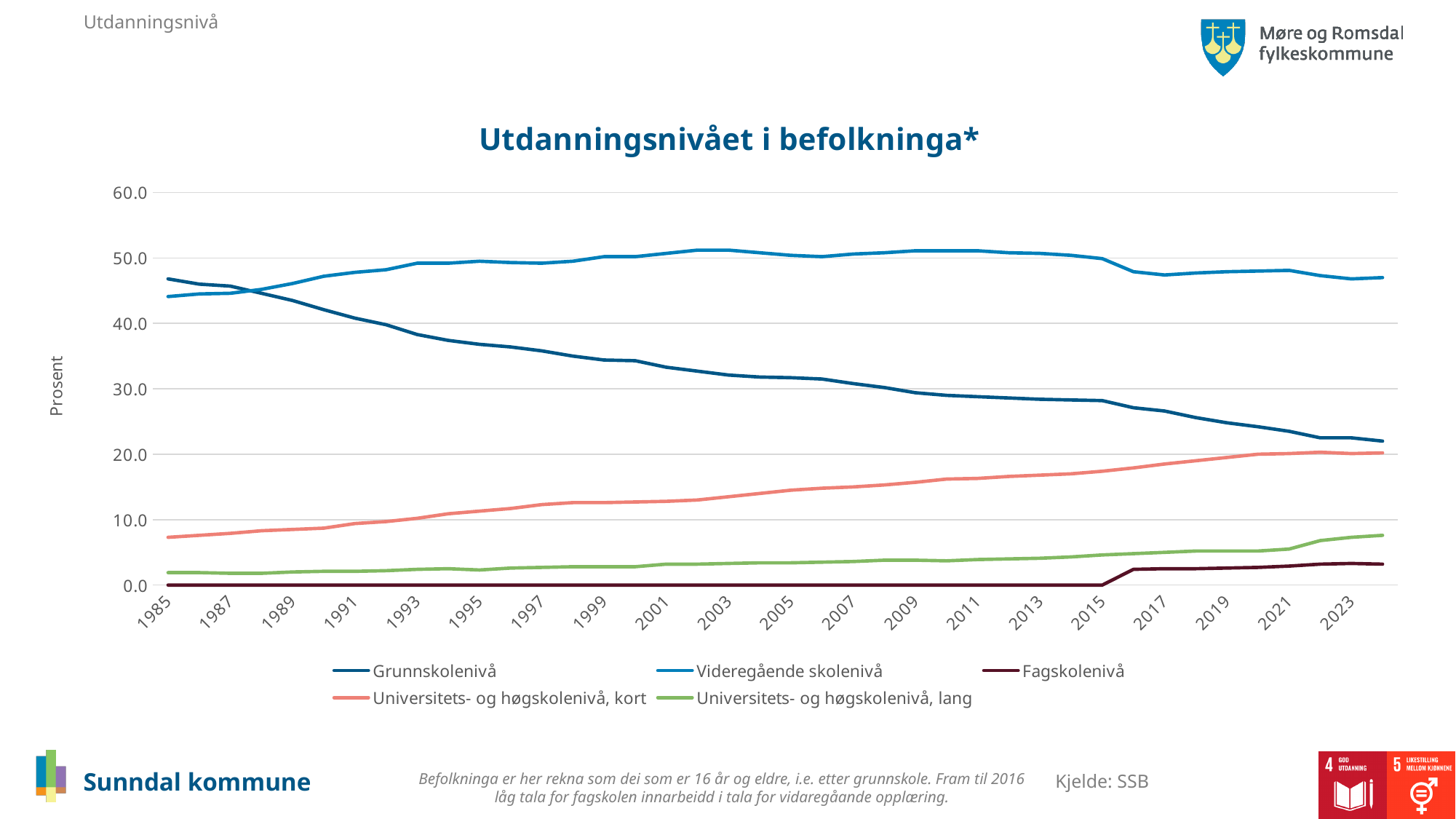
What kind of chart is shown on the slide? Line chart In 2023, which is larger: Universitets- og høgskolenivå, kort or Universitets- og høgskolenivå, lang? Universitets- og høgskolenivå, kort What is the title of the chart? Utdanningsnivået i befolkninga* Which series has the highest value in 2023? Videregående skolenivå Which series has the highest value in 1985? Grunnskolenivå What is the label on the y axis? Prosent Is the value for Grunnskolenivå in 2023 greater or less than 30.0? less How many series does the legend list? 5 Does the Grunnskolenivå line rise or fall from 1985 to 2023? Fall Is the value for Videregående skolenivå in 2023 greater or less than 40.0? greater Which series has the lowest value in 2023? Fagskolenivå Does the Universitets- og høgskolenivå, kort line rise or fall from 1985 to 2023? Rise